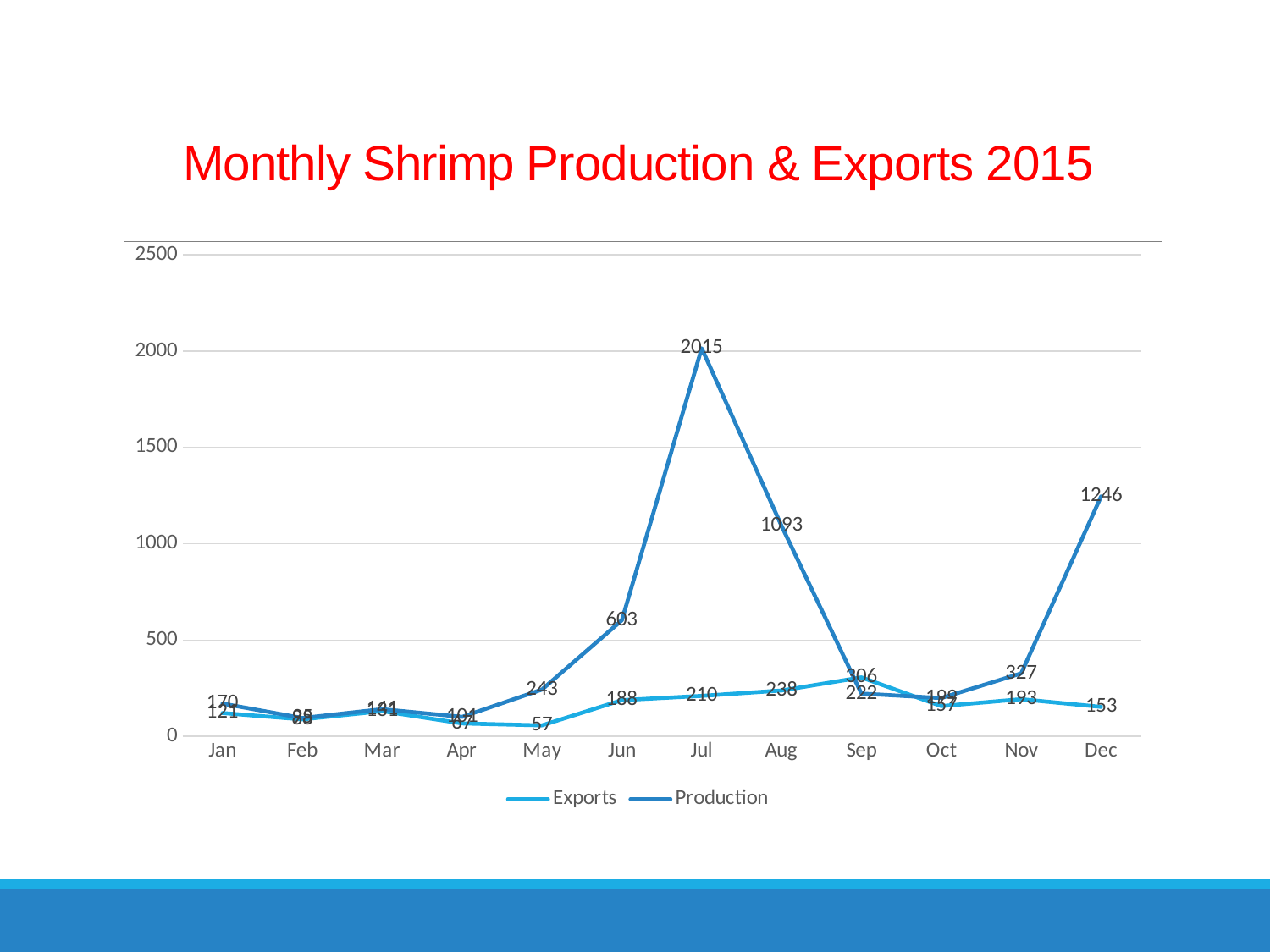
What is the Exports value for May? 57 How many months are shown on the x axis? 12 What is the Exports value for Aug? 238 What is the Production value for Jul? 2015 Which is larger: Production in Dec or Production in Aug? Production in Dec What is the Production value for Aug? 1093 What is the Production value for Dec? 1246 What is the difference between Production in Jul and Production in Aug? 922 In which month is Exports lowest? May What type of chart is shown on the slide? Line chart In which month is Production highest? Jul Is the Production value for Jun greater or less than 500? greater